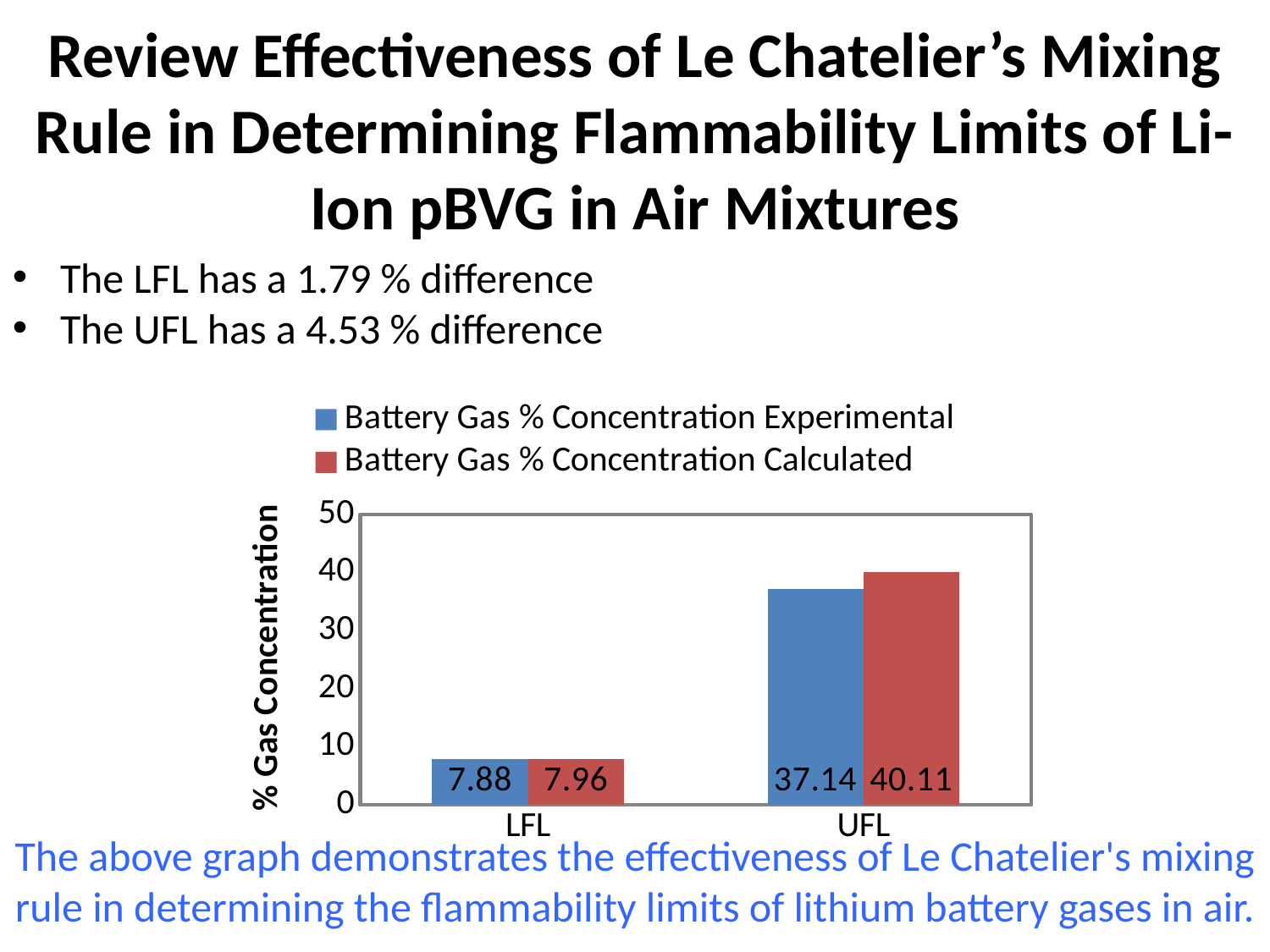
Which category has the highest Battery Gas % Concentration Calculated value? UFL Which category has the lowest Battery Gas % Concentration Experimental value? LFL What is the Battery Gas % Concentration Calculated value for LFL? 7.96 For UFL, which is larger: the Experimental value or the Calculated value? Calculated What kind of chart is shown on the slide? bar chart What is the Battery Gas % Concentration Calculated value for UFL? 40.11 What is the Battery Gas % Concentration Experimental value for UFL? 37.14 How many series does the legend list? 2 Is the Battery Gas % Concentration Experimental value for UFL greater or less than 30? greater What is the Battery Gas % Concentration Experimental value for LFL? 7.88 How many categories are shown on the x axis? 2 What is the difference between the Calculated and Experimental values for UFL? 2.97